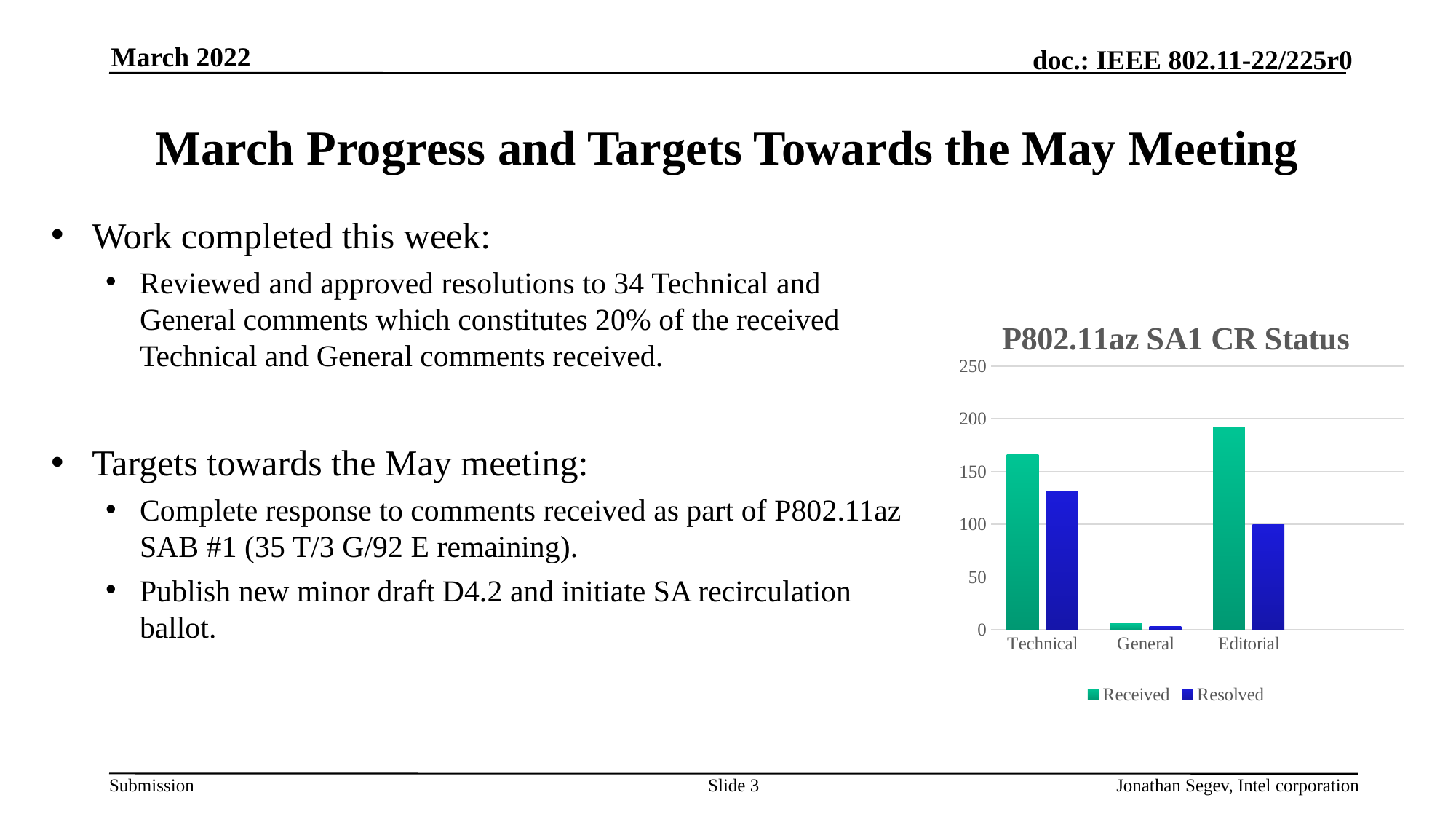
Is the Received value for Technical greater or less than 150? greater How many series does the chart legend list? 2 Which category has the highest Resolved value? Technical Which category has the highest Received value? Editorial Which category has the lowest Received value? General Is the Received value for Editorial greater or less than 200? less How many categories are shown on the x axis of the chart? 3 What type of chart is shown on the slide? bar chart What is the title of the chart? P802.11az SA1 CR Status Which is larger for Technical: the Received value or the Resolved value? Received Is the Resolved value for Editorial greater or less than 150? less Which series is shown in blue in the chart? Resolved